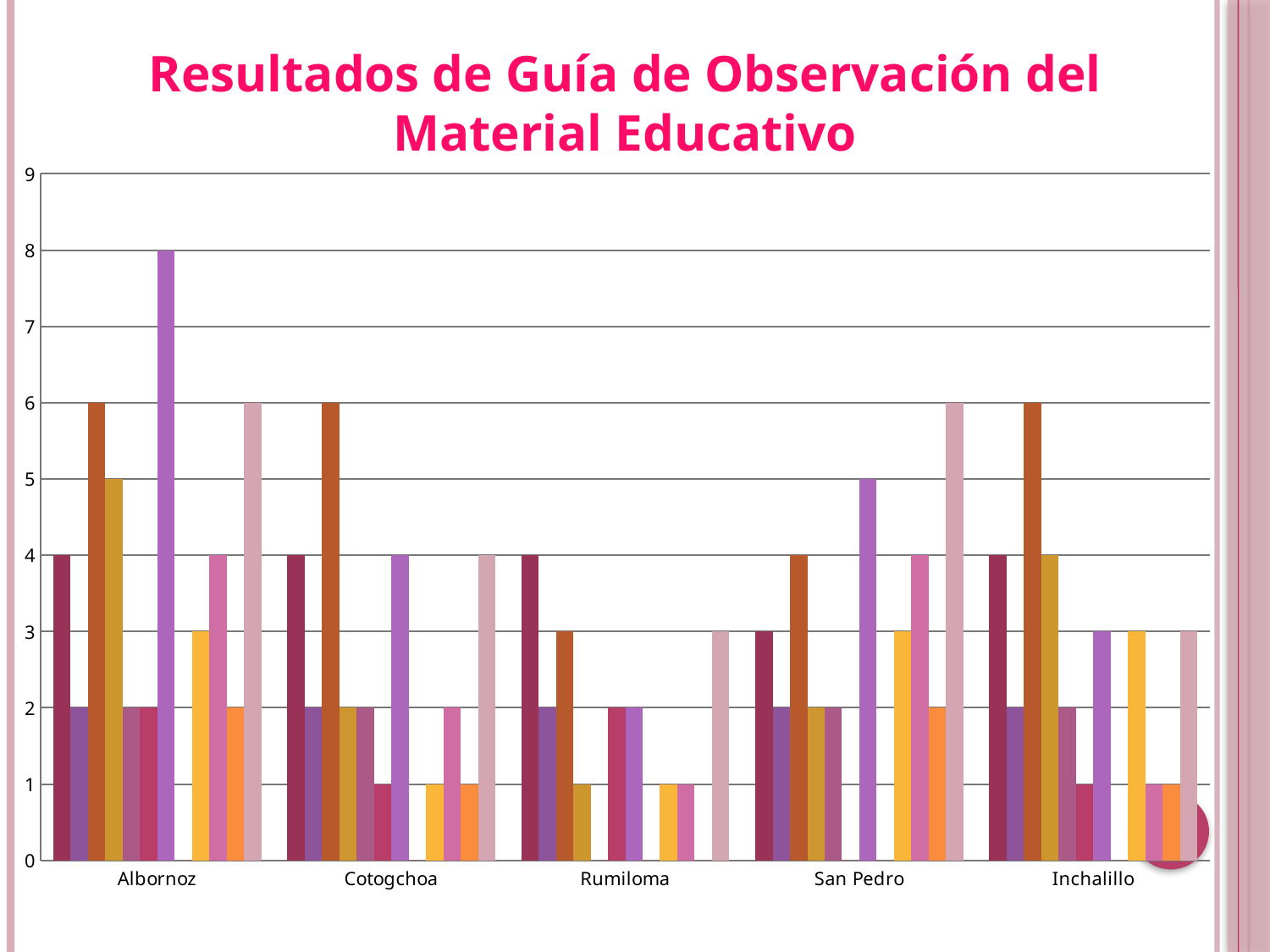
How many categories are shown on the x axis of the chart? 5 Which group has the taller maximum bar, Albornoz or Rumiloma? Albornoz What kind of chart is shown on the slide? bar chart Which category contains the tallest bar in the chart? Albornoz Is the tallest bar in the Rumiloma group greater or less than 5? less What is the difference between the tallest bar in Albornoz and the tallest bar in Rumiloma? 4 What value does the tallest bar in the San Pedro group reach? 6 Is the tallest bar in the Albornoz group greater or less than 7? greater What is the title of the chart on the slide? Resultados de Guía de Observación del Material Educativo What value does the tallest bar in the Rumiloma group reach? 4 What value does the tallest bar in the Albornoz group reach? 8 What value does the leftmost bar in the Albornoz group reach? 4